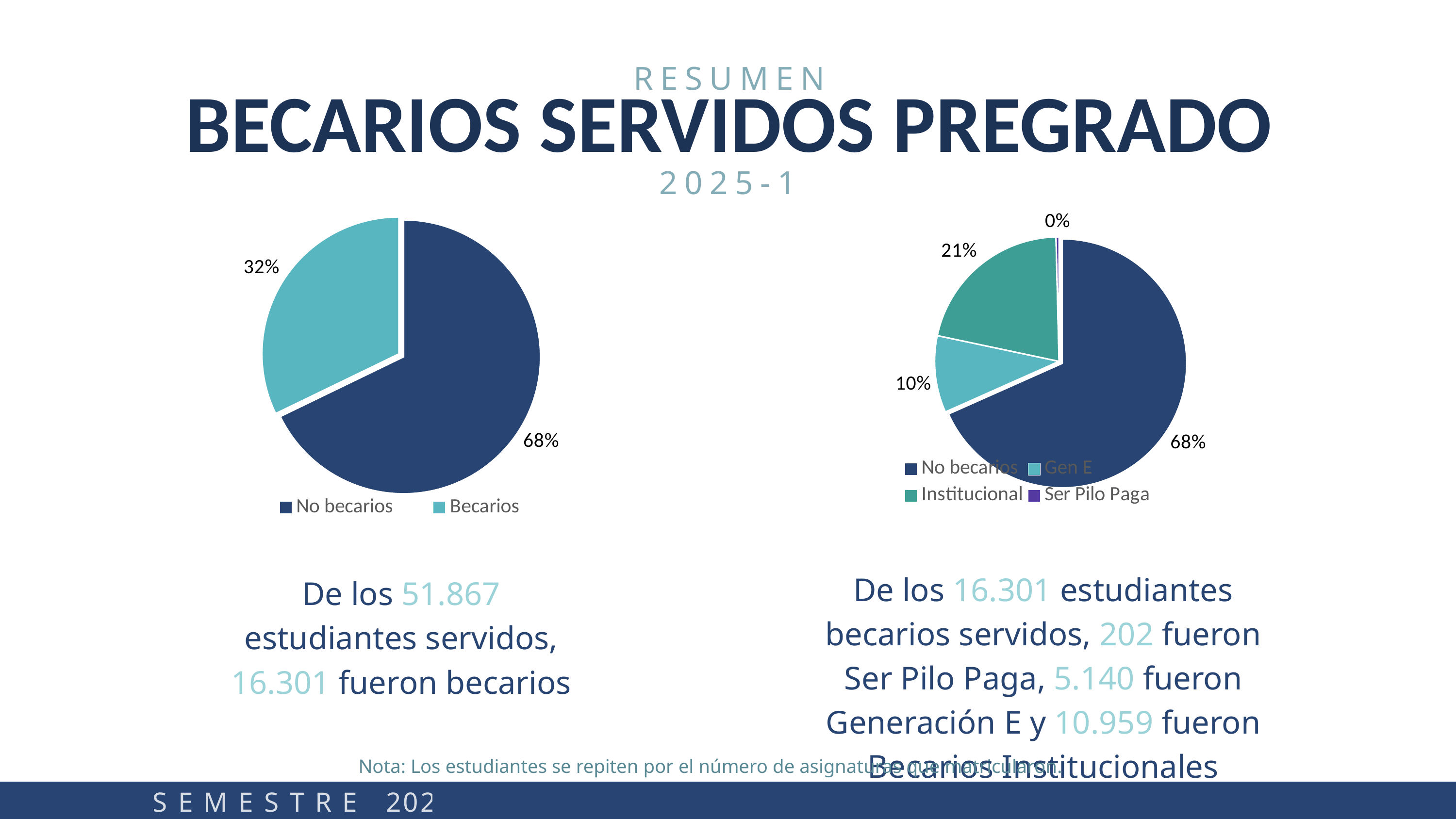
In the right pie chart, what percentage is shown for Ser Pilo Paga? 0% In the left pie chart, what is the difference in percentage points between No becarios and Becarios? 36 What type of chart is the left chart? Pie chart In the right pie chart, what percentage is shown for Institucional? 21% In the left pie chart, which category has the largest slice? No becarios In the left pie chart, what percentage is shown for No becarios? 68% In the right pie chart, which is larger, Institucional or Gen E? Institucional In the left pie chart, what percentage is shown for Becarios? 32% In the right pie chart, which category has the smallest slice? Ser Pilo Paga In the right pie chart, what percentage is shown for Gen E? 10% How many categories does the legend of the right pie chart list? 4 How many categories does the legend of the left pie chart list? 2